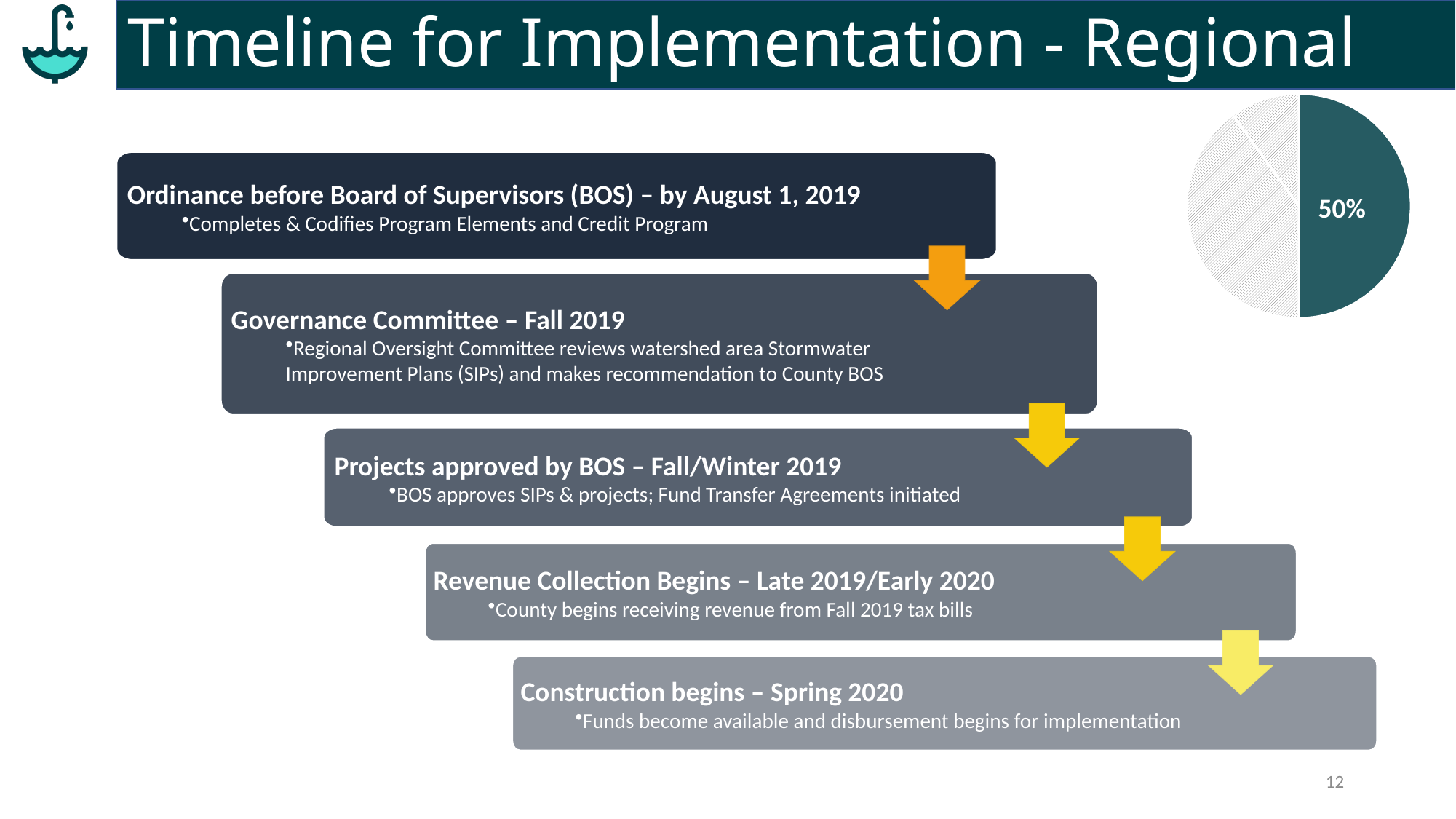
What share of the pie chart does the solid dark teal slice represent? 50% What kind of chart is shown in the top right corner of the slide? pie chart What value is printed on the solid dark teal slice of the pie chart? 50% What colour is the slice of the pie chart labelled 50%? dark teal How many slices of the pie chart carry a printed data label? 1 Does the pie chart on the slide have a legend? No